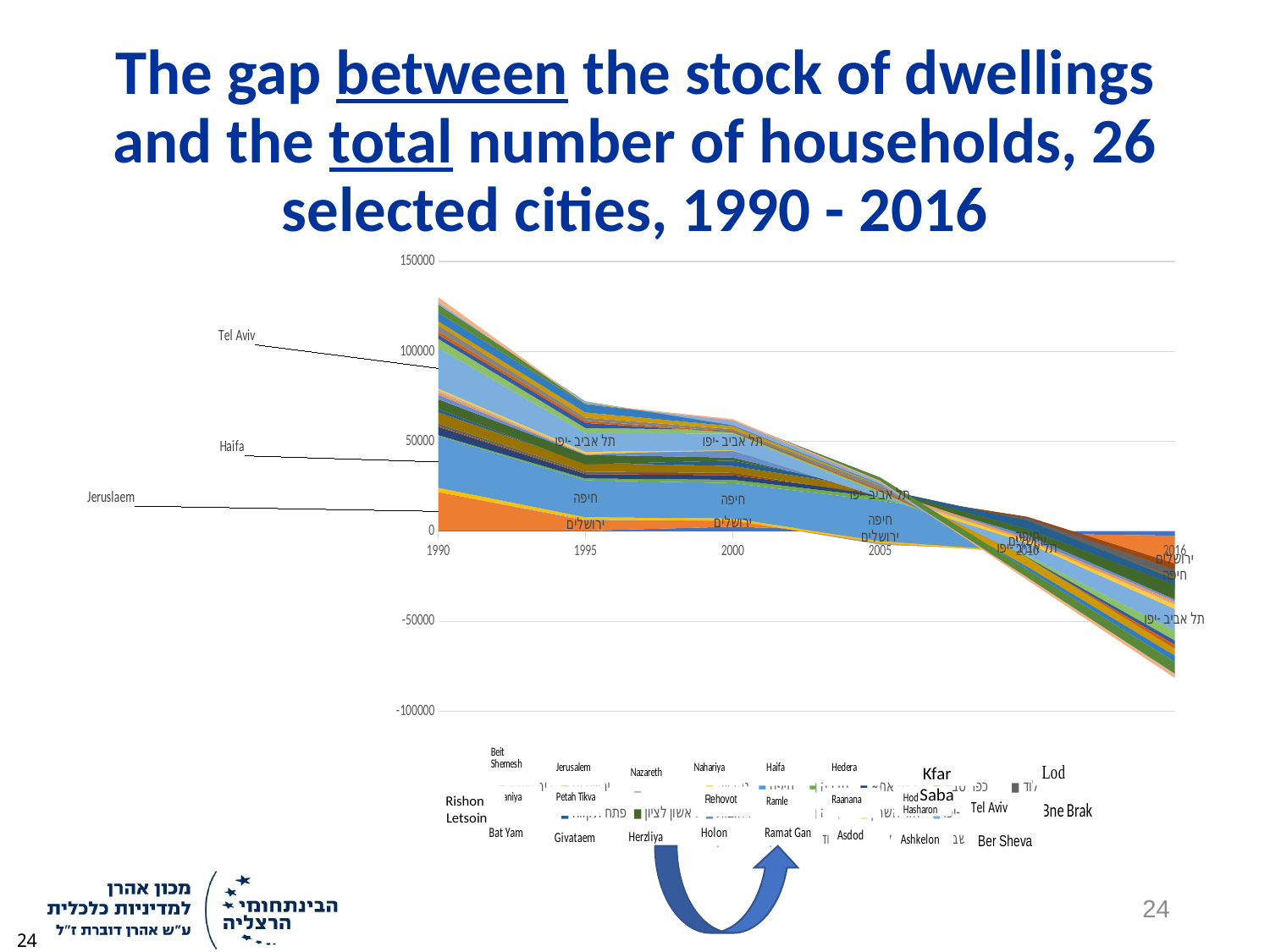
In which year is the stacked total at its highest? 1990 What is the last year shown on the x axis? 2016 What is the highest value marked on the y axis? 150000 How many cities does the chart title say are included? 26 What is the first year shown on the x axis? 1990 In which year is the stacked total at its lowest? 2016 Is the stacked total in 1990 greater or less than 100000? greater What kind of chart is shown on the slide? Area chart Do the stacked values rise or fall from 1990 to 2016? Fall How many years are marked along the x axis of the chart? 6 What is the title of the chart on the slide? The gap between the stock of dwellings and the total number of households, 26 selected cities, 1990 - 2016 Is the stacked total in 2016 greater or less than -50000? less